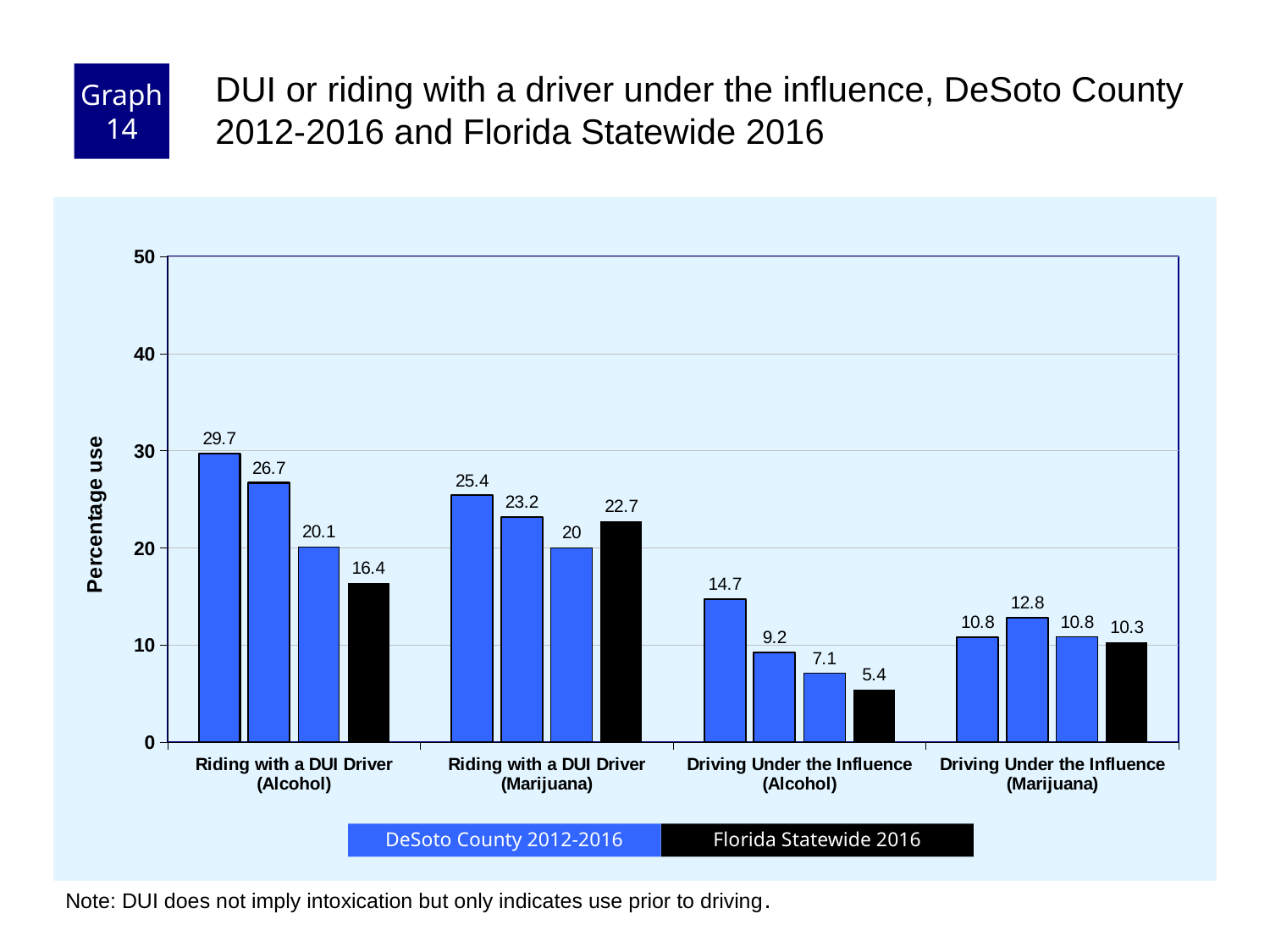
What is the lowest value shown anywhere on the chart? 5.4 Which is larger: the Florida Statewide 2016 value for Riding with a DUI Driver (Marijuana) or for Riding with a DUI Driver (Alcohol)? Riding with a DUI Driver (Marijuana) What kind of chart is shown on the slide? Bar chart How many series does the legend list? 2 What is the Florida Statewide 2016 value for Driving Under the Influence (Marijuana)? 10.3 What is the Florida Statewide 2016 value for Riding with a DUI Driver (Alcohol)? 16.4 What is the Florida Statewide 2016 value for Riding with a DUI Driver (Marijuana)? 22.7 What is the Florida Statewide 2016 value for Driving Under the Influence (Alcohol)? 5.4 What is the highest value shown in the Riding with a DUI Driver (Alcohol) group? 29.7 How many category groups are shown on the x axis? 4 What is the label of the y axis? Percentage use What is the difference between the Florida Statewide 2016 values for Riding with a DUI Driver (Marijuana) and Riding with a DUI Driver (Alcohol)? 6.3